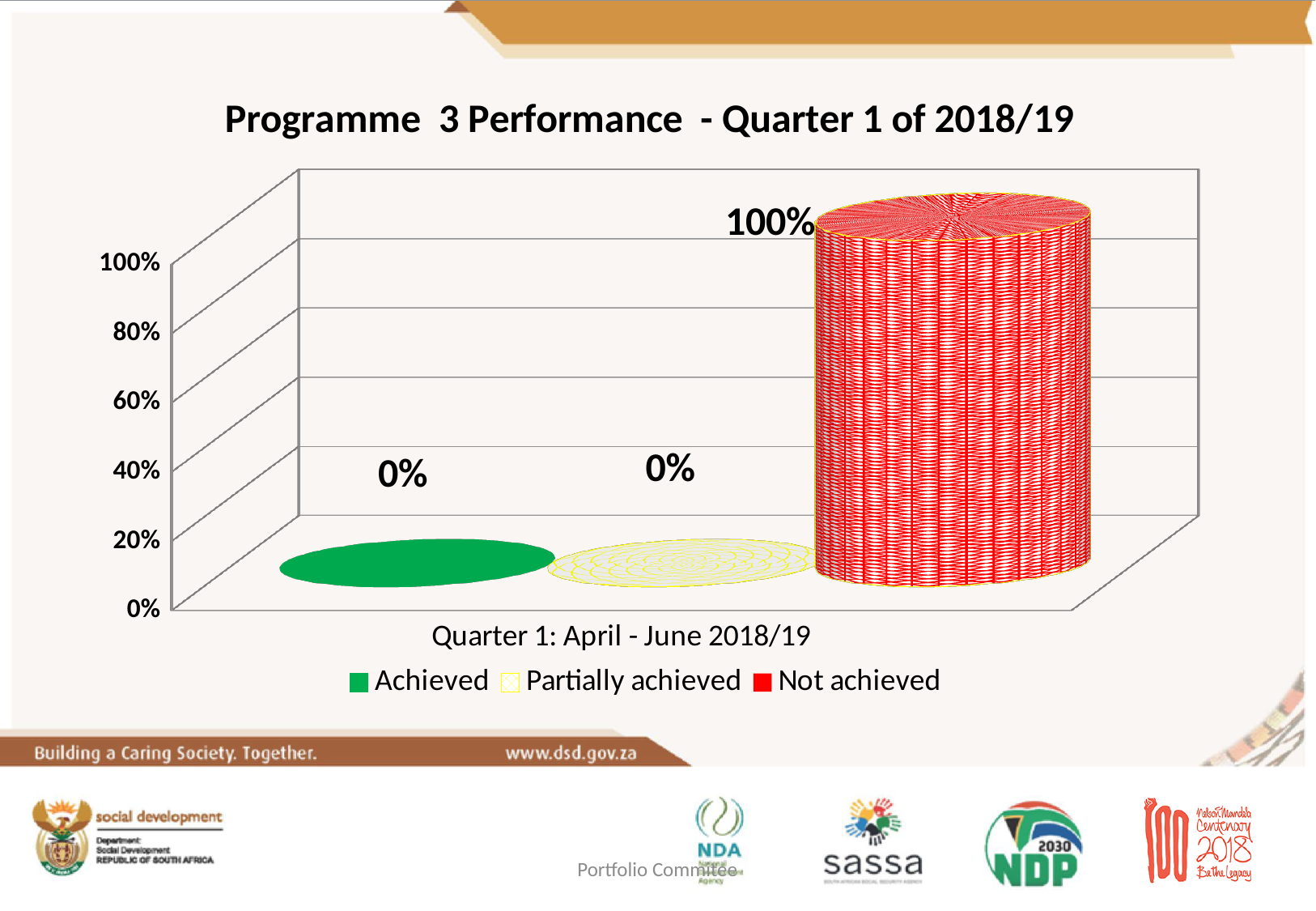
Which is larger, the value for Not achieved or the value for Partially achieved? Not achieved What is the value for Partially achieved in Quarter 1: April - June 2018/19? 0% Is the value for Not achieved greater or less than 80%? greater What is the category label shown on the x axis? Quarter 1: April - June 2018/19 How many series does the legend list? 3 What is the value for Not achieved in Quarter 1: April - June 2018/19? 100% What is the difference between the Not achieved value and the Achieved value? 100% What kind of chart is shown on the slide? Bar chart What is the value for Achieved in Quarter 1: April - June 2018/19? 0% Which series has the highest value in the chart? Not achieved What colour represents the Not achieved series in the legend? Red What is the title of the chart? Programme 3 Performance - Quarter 1 of 2018/19